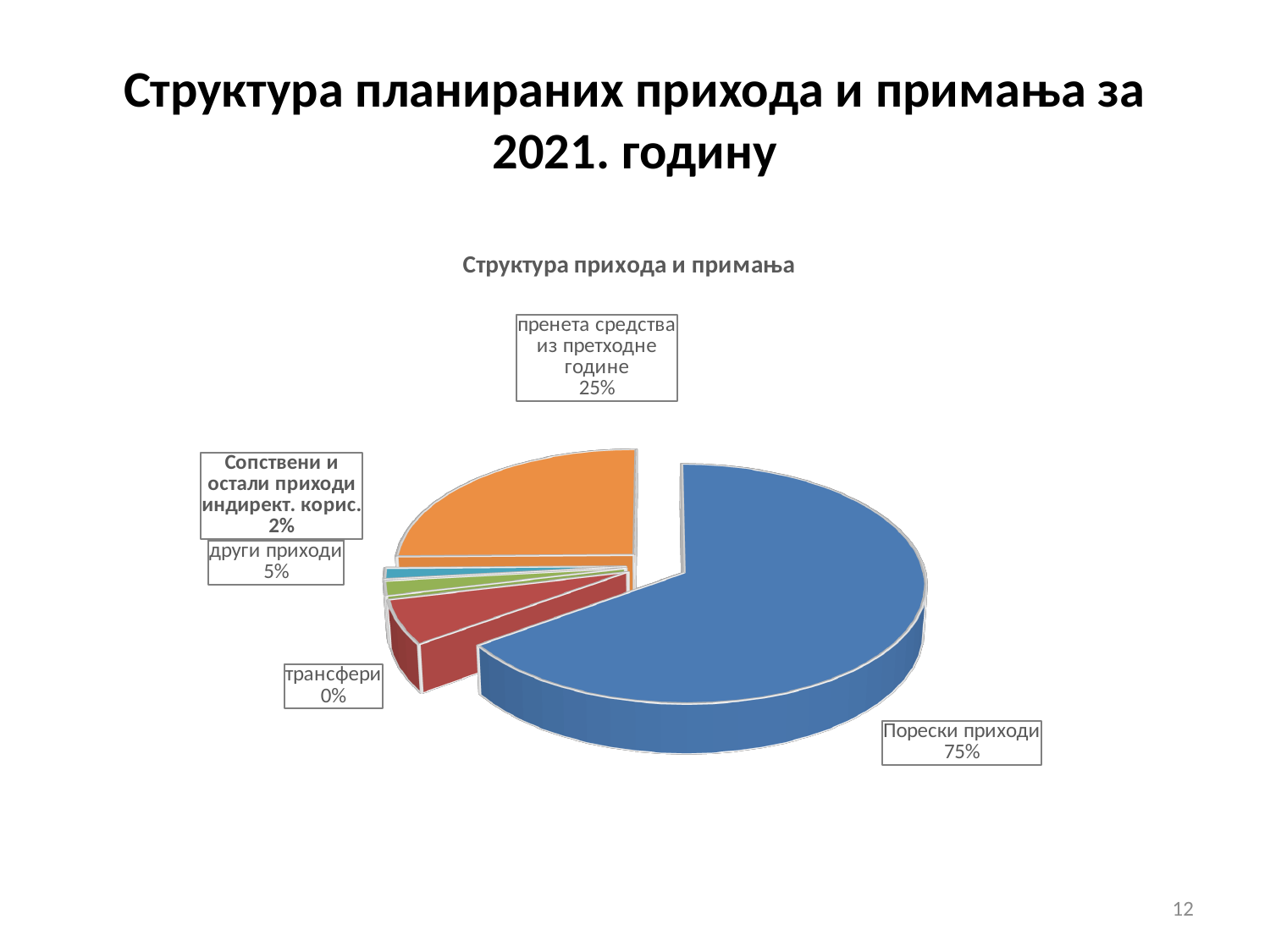
Which category has the largest slice of the pie? Порески приходи What share of the pie is labelled for Сопствени и остали приходи индирект. корис.? 2% How many slices are labelled in the pie chart? 5 Which is larger, the share for пренета средства из претходне године or the share for други приходи? пренета средства из претходне године What share of the pie is labelled for трансфери? 0% What kind of chart is shown on the slide? pie chart What share of the pie is labelled for пренета средства из претходне године? 25% What is the title of the chart? Структура прихода и примања Which category has the smallest labelled share of the pie? трансфери What is the difference in percentage points between the share for Порески приходи and the share for пренета средства из претходне године? 50 percentage points